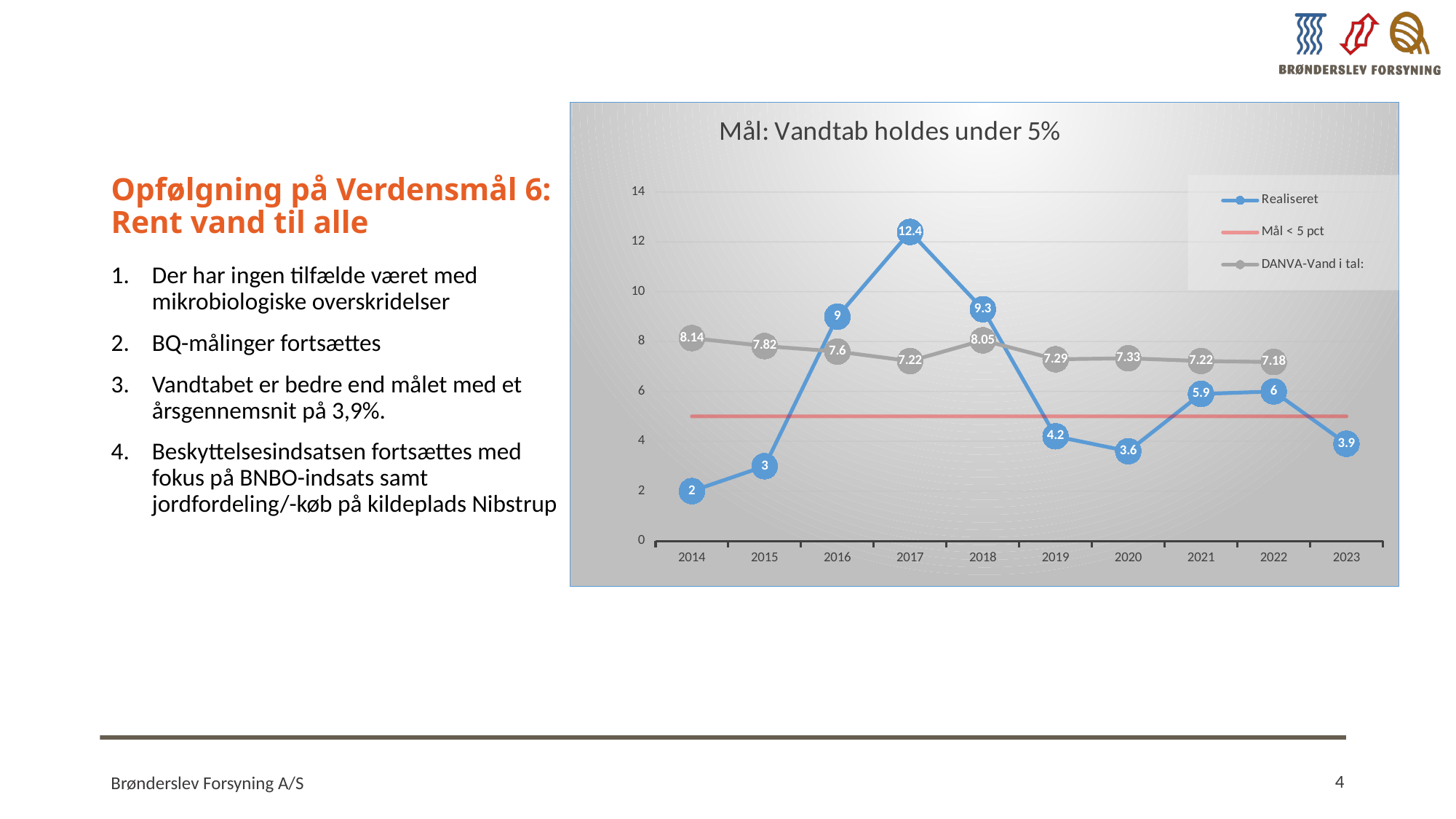
What is the DANVA-Vand i tal value for 2014? 8.14 What kind of chart is shown? line chart How many years are shown on the x axis? 10 What is the Realiseret value for 2017? 12.4 Is the Realiseret value for 2017 greater or less than 10? greater What is the difference between the Realiseret values for 2017 and 2018? 3.1 Which year has the lowest Realiseret value? 2014 How many series does the legend list? 3 What is the title of the chart? Mål: Vandtab holdes under 5% Which is larger in 2016, the Realiseret value or the DANVA-Vand i tal value? Realiseret What is the Realiseret value for 2023? 3.9 Which year has the highest Realiseret value? 2017